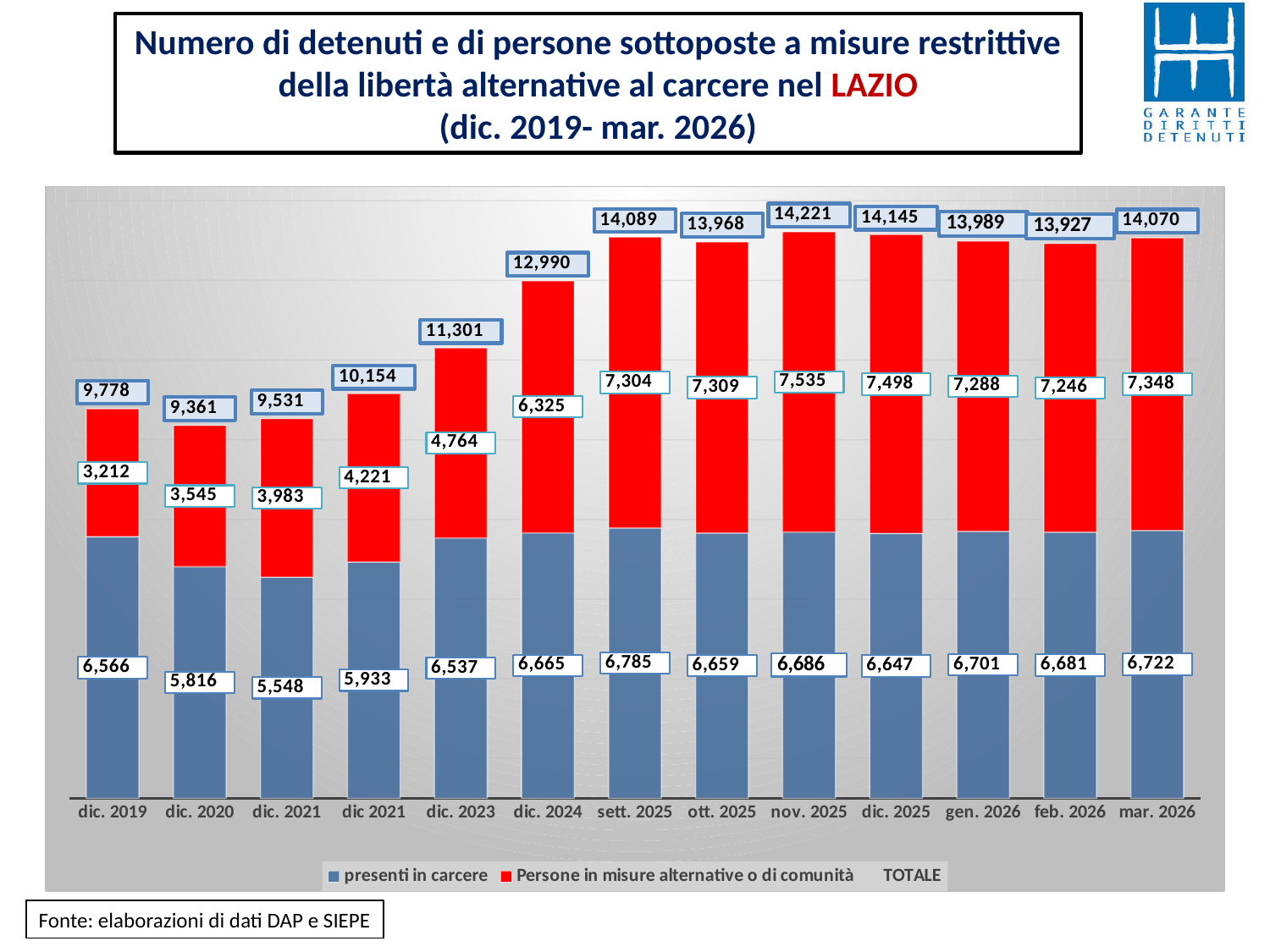
What is the value for 'presenti in carcere' in dic. 2019? 6,566 Which period has the highest TOTALE value? nov. 2025 What is the value for 'Persone in misure alternative o di comunità' in mar. 2026? 7,348 What is the source cited at the bottom of the slide? Fonte: elaborazioni di dati DAP e SIEPE Which is larger in sett. 2025: 'presenti in carcere' or 'Persone in misure alternative o di comunità'? Persone in misure alternative o di comunità How many series does the legend list? 3 What is the difference between the TOTALE values for mar. 2026 and dic. 2019? 4,292 What is the total of the stacked bar for dic. 2024? 12,990 What type of chart is shown on the slide? stacked bar chart What is the TOTALE value for nov. 2025? 14,221 Which period has the lowest value for 'presenti in carcere'? dic. 2021 Does the TOTALE value generally rise or fall from dic. 2019 to sett. 2025? rise